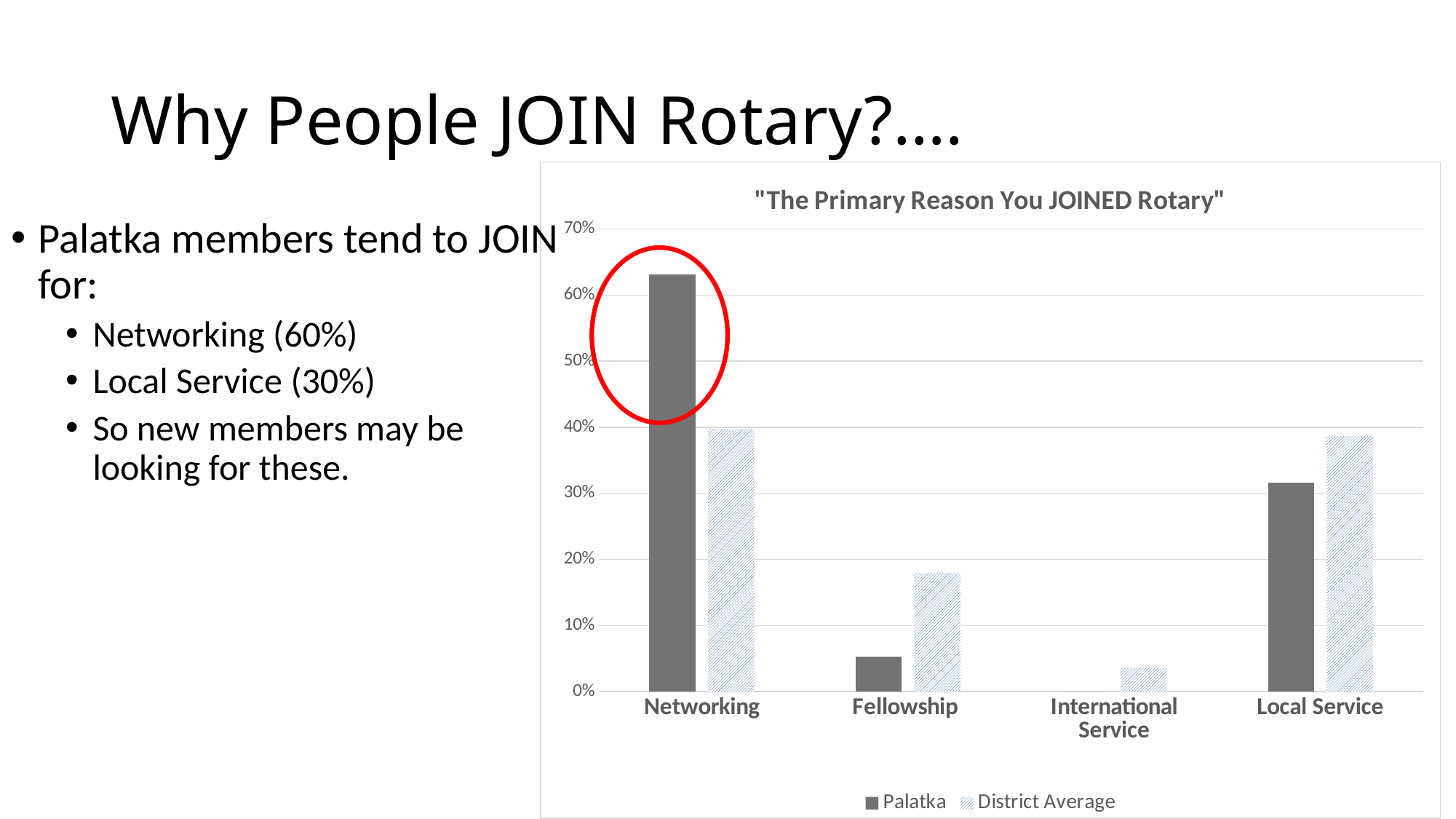
For Networking, which is larger: the Palatka value or the District Average value? Palatka Which category has the lowest District Average value? International Service What kind of chart is shown on the slide? bar chart Which series is drawn with solid dark grey bars? Palatka How many categories are shown on the x axis of the chart? 4 What is the title of the chart? "The Primary Reason You JOINED Rotary" How many series does the chart legend list? 2 Which category has the lowest Palatka value? International Service Is the District Average value for Fellowship greater or less than 20%? less Which category has the highest Palatka value? Networking Is the Palatka value for Networking greater or less than 60%? greater For Local Service, which is larger: the Palatka value or the District Average value? District Average